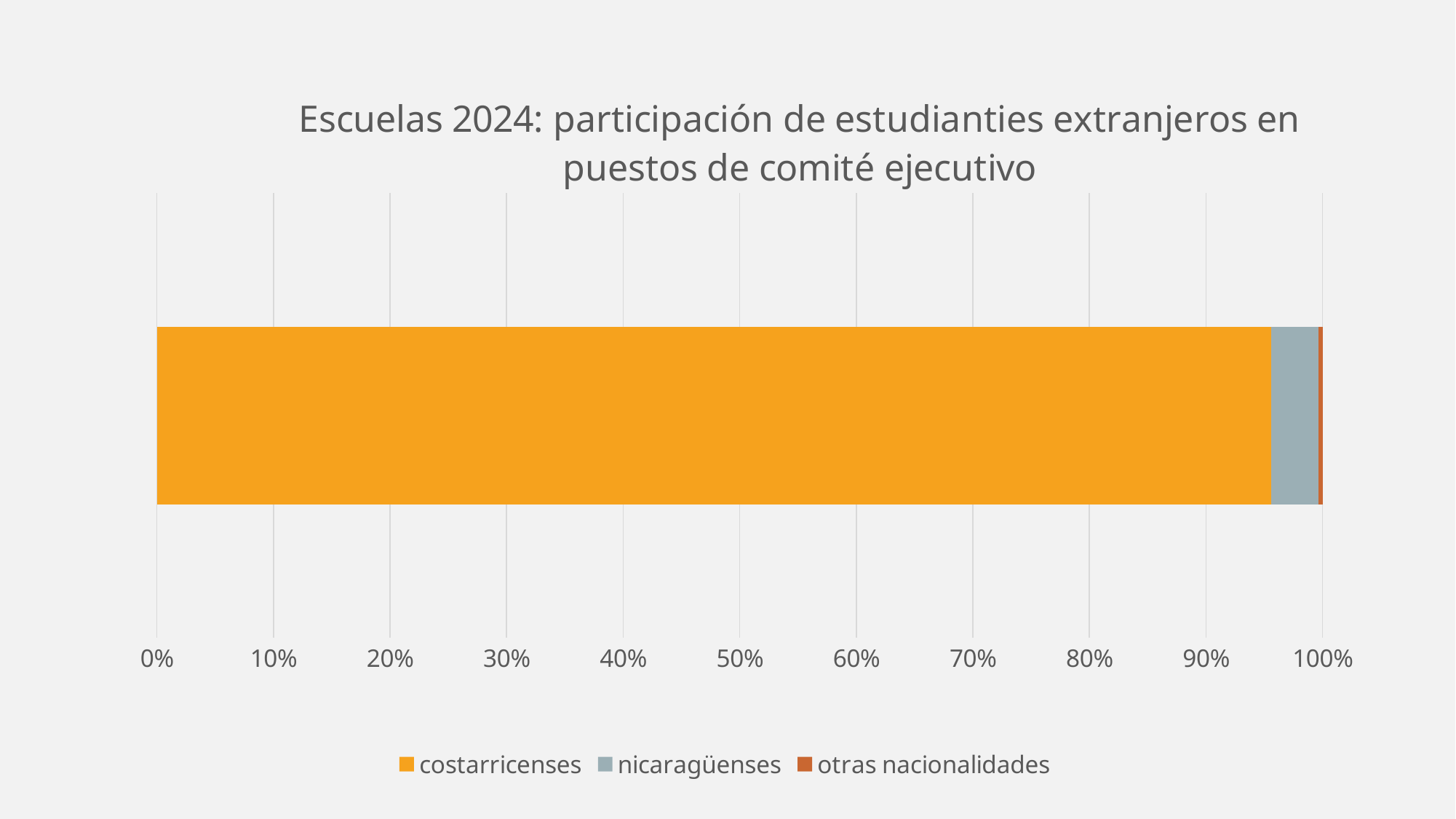
Which series takes up the smallest share of the bar? otras nacionalidades Which series takes up the largest share of the bar? costarricenses Which is larger, the share for costarricenses or the share for nicaragüenses? costarricenses Which is larger, the share for nicaragüenses or the share for otras nacionalidades? nicaragüenses What kind of chart is shown on the slide? bar chart How many series does the legend list? 3 Is the share for costarricenses greater or less than 90%? greater What is the title of the chart? Escuelas 2024: participación de estudianties extranjeros en puestos de comité ejecutivo Is the share for nicaragüenses greater or less than 10%? less Is the share for otras nacionalidades greater or less than 10%? less Which series is shown in orange in the legend? costarricenses How many bars are plotted in the chart? 1